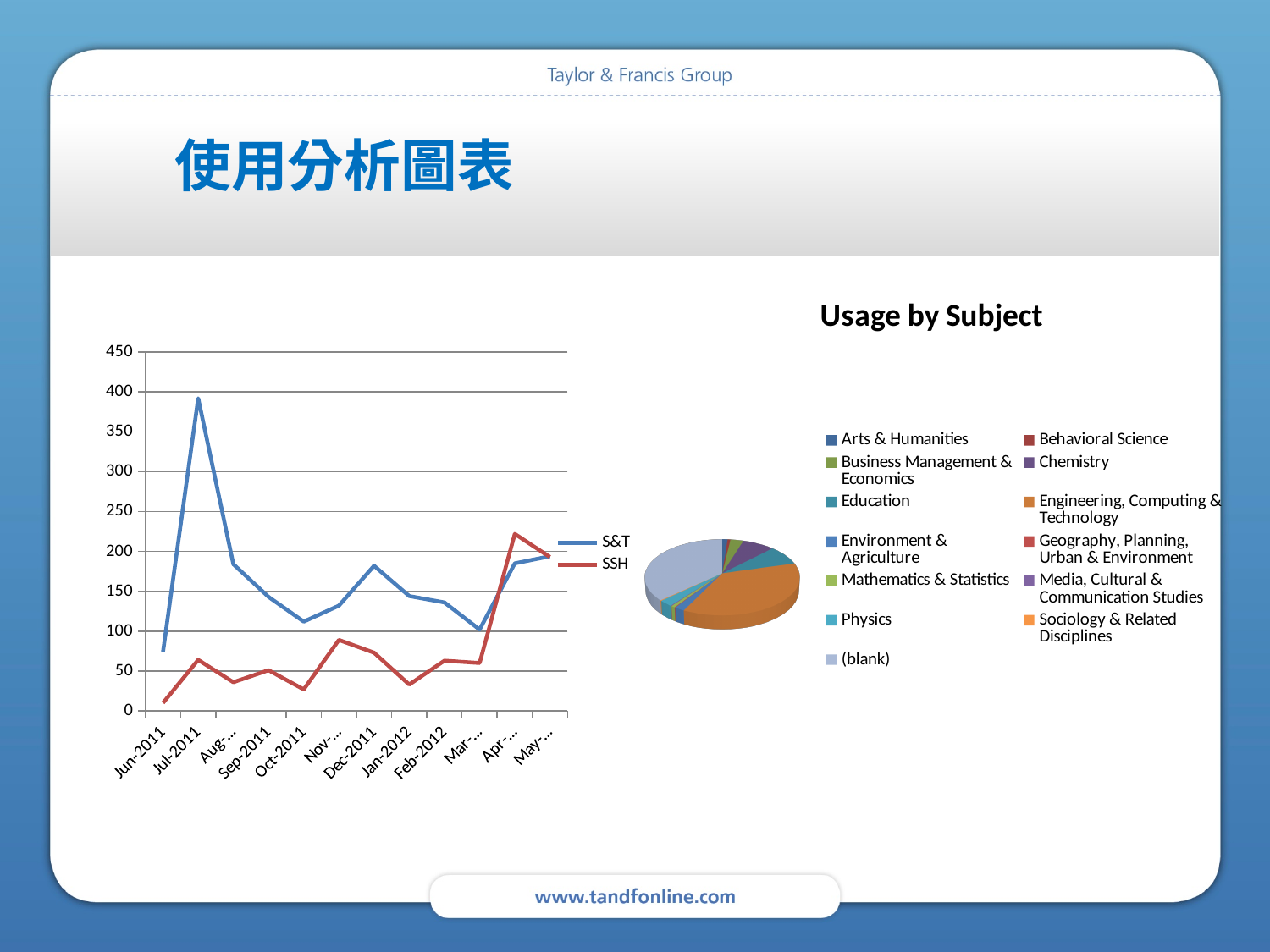
In the left line chart, is the S&T value for Jul-2011 greater or less than 350? greater In the left line chart, in which month does the SSH series reach its highest value? Apr-2012 What kind of chart is the 'Usage by Subject' chart? pie chart How many months are plotted along the x axis of the left line chart? 12 What kind of chart is the chart on the left of the slide? line chart In the left line chart, in which month does the S&T series reach its highest value? Jul-2011 In the left line chart, in which month is the S&T series at its lowest value? Jun-2011 How many series does the legend of the left line chart list? 2 How many subject categories does the legend of the 'Usage by Subject' pie chart list? 13 In the left line chart, is the SSH value for Jun-2011 greater or less than 50? less In the left line chart, which series has the larger value in Jul-2011, S&T or SSH? S&T